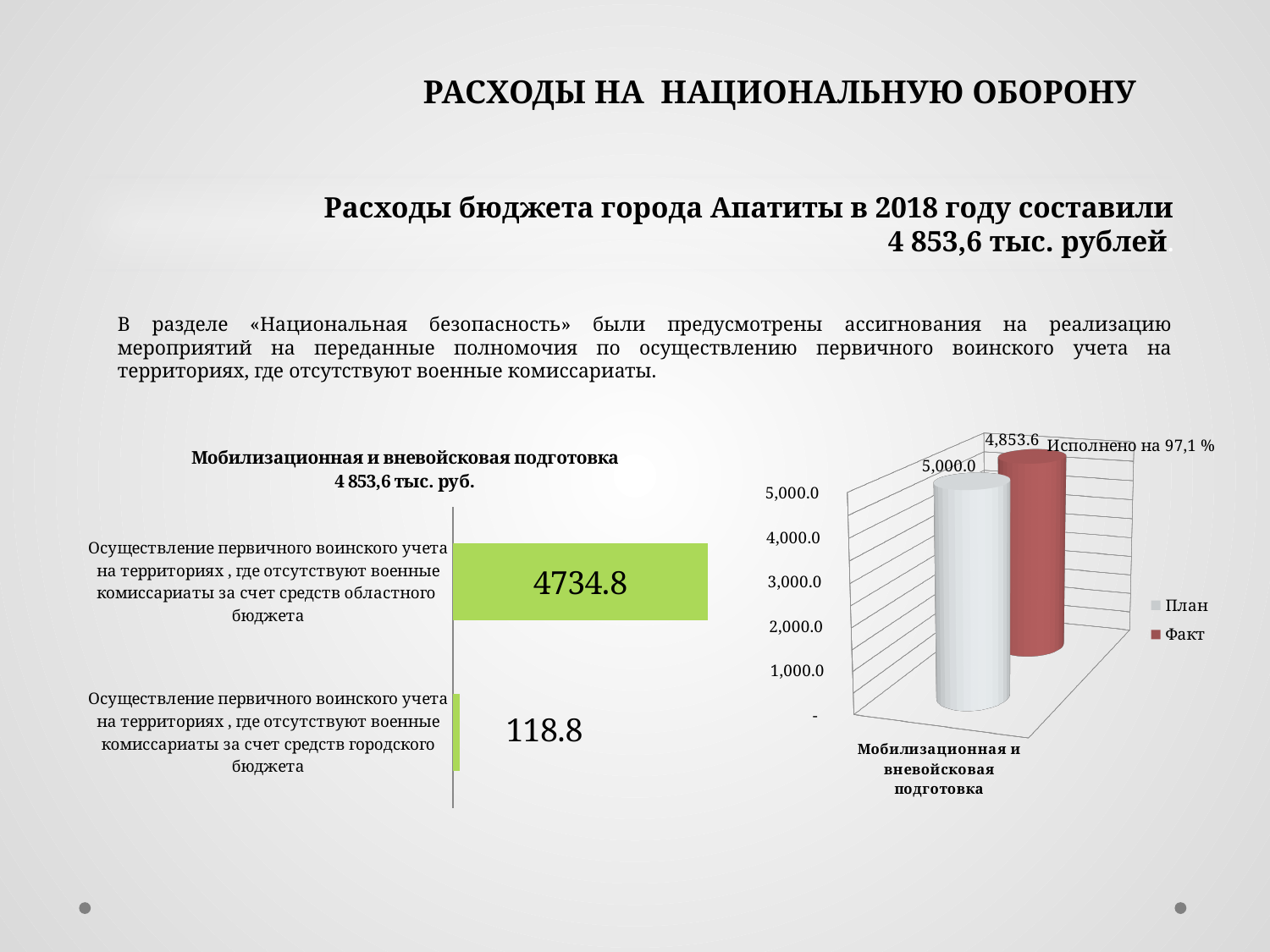
On the left chart, how many categories are plotted? 2 On the right chart, what percentage of execution is stated next to the 'Факт' bar? 97,1 % On the right chart, what is the difference between 'План' and 'Факт'? 146.4 On the left chart, what is the difference between the two bar values? 4616.0 On the right chart, which is larger, 'План' or 'Факт'? План On the right chart, what is the value for 'План'? 5,000.0 On the left chart, what is the value for 'Осуществление первичного воинского учета ... за счет средств городского бюджета'? 118.8 On the left chart, which category has the highest value? Осуществление первичного воинского учета на территориях, где отсутствуют военные комиссариаты за счет средств областного бюджета What kind of chart is the left chart? Bar chart On the right chart, what is the value for 'Факт'? 4,853.6 On the right chart, how many series does the legend list? 2 On the left chart, what is the value for 'Осуществление первичного воинского учета ... за счет средств областного бюджета'? 4734.8